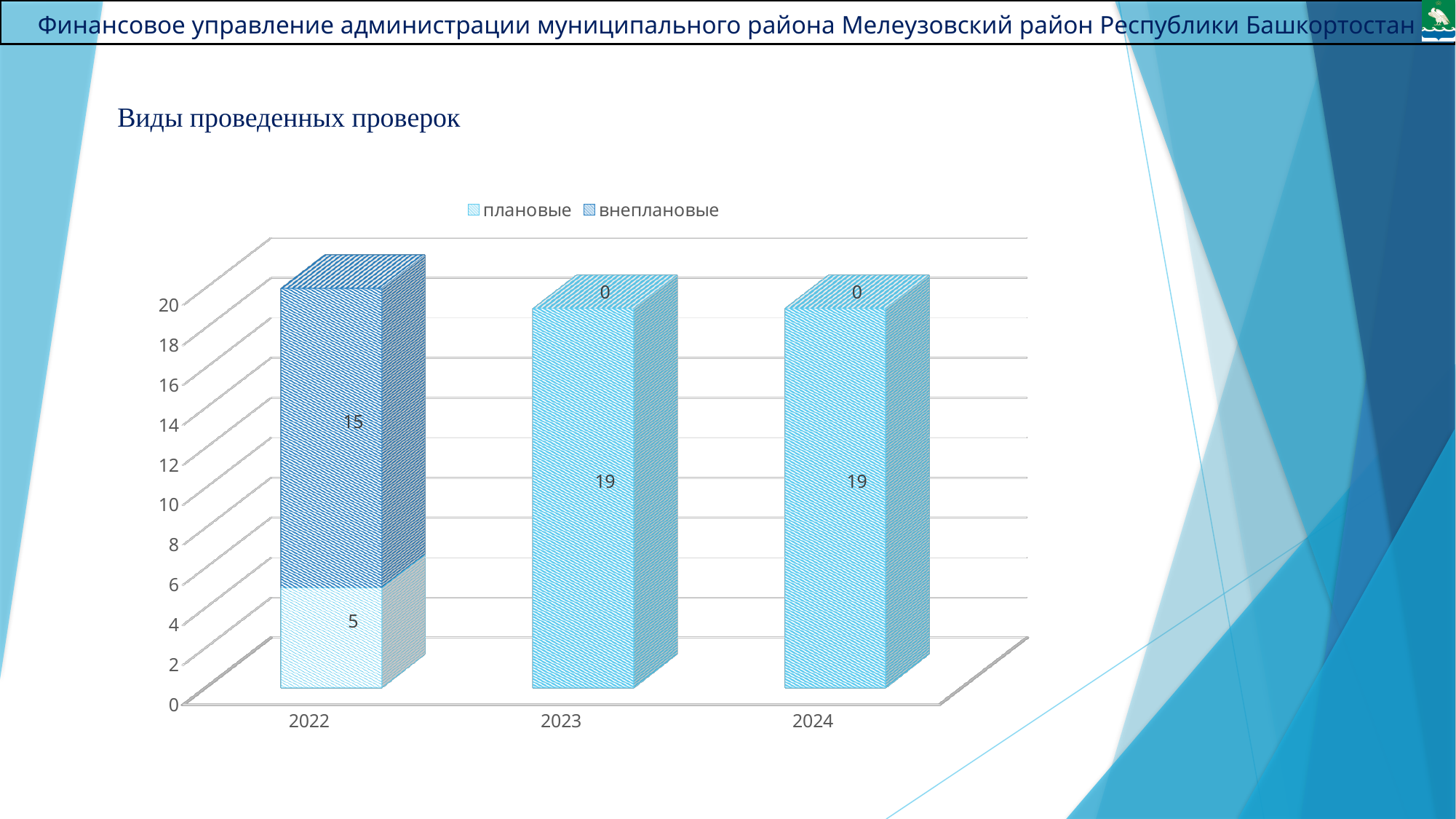
How many years are shown on the x axis? 3 What is the value for плановые in 2022? 5 Which is larger in 2022: плановые or внеплановые? внеплановые What is the total of the stacked bar for 2022? 20 What is the value for внеплановые in 2024? 0 What is the value for плановые in 2023? 19 How many series does the legend list? 2 What kind of chart is shown on the slide? Stacked bar chart In which year is the value for внеплановые highest? 2022 In which year is the value for плановые lowest? 2022 What is the value for внеплановые in 2022? 15 What is the difference between внеплановые and плановые in 2022? 10